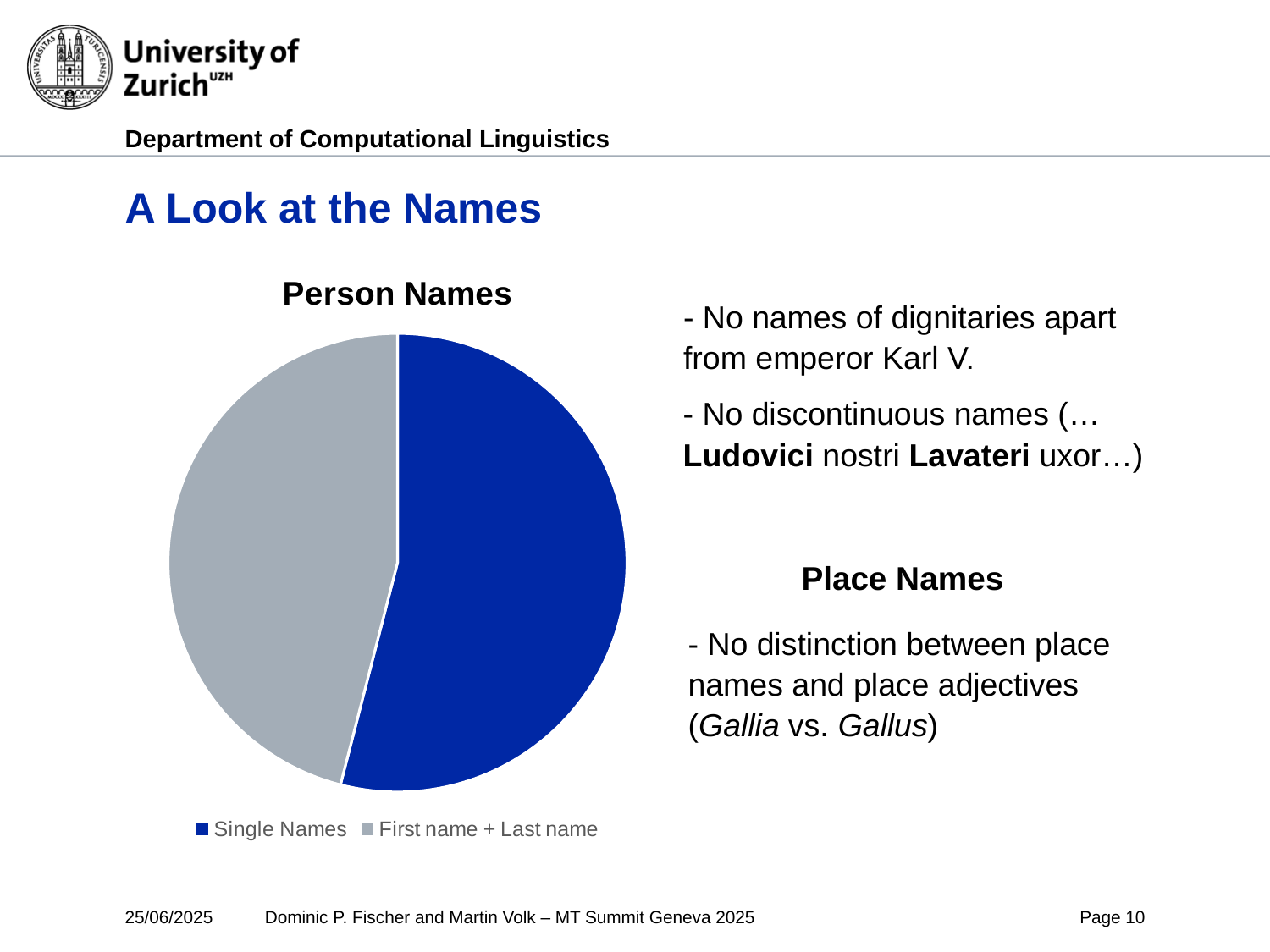
What kind of chart is shown under the heading "Person Names"? pie chart How many entries does the legend of the "Person Names" pie chart list? 2 Which colour represents "Single Names" in the pie chart? blue In the "Person Names" pie chart, which is larger: "Single Names" or "First name + Last name"? Single Names Which slice of the "Person Names" pie chart is the largest? Single Names Which slice of the "Person Names" pie chart is the smallest? First name + Last name How many slices does the "Person Names" pie chart have? 2 What is the title of the pie chart on the slide? Person Names